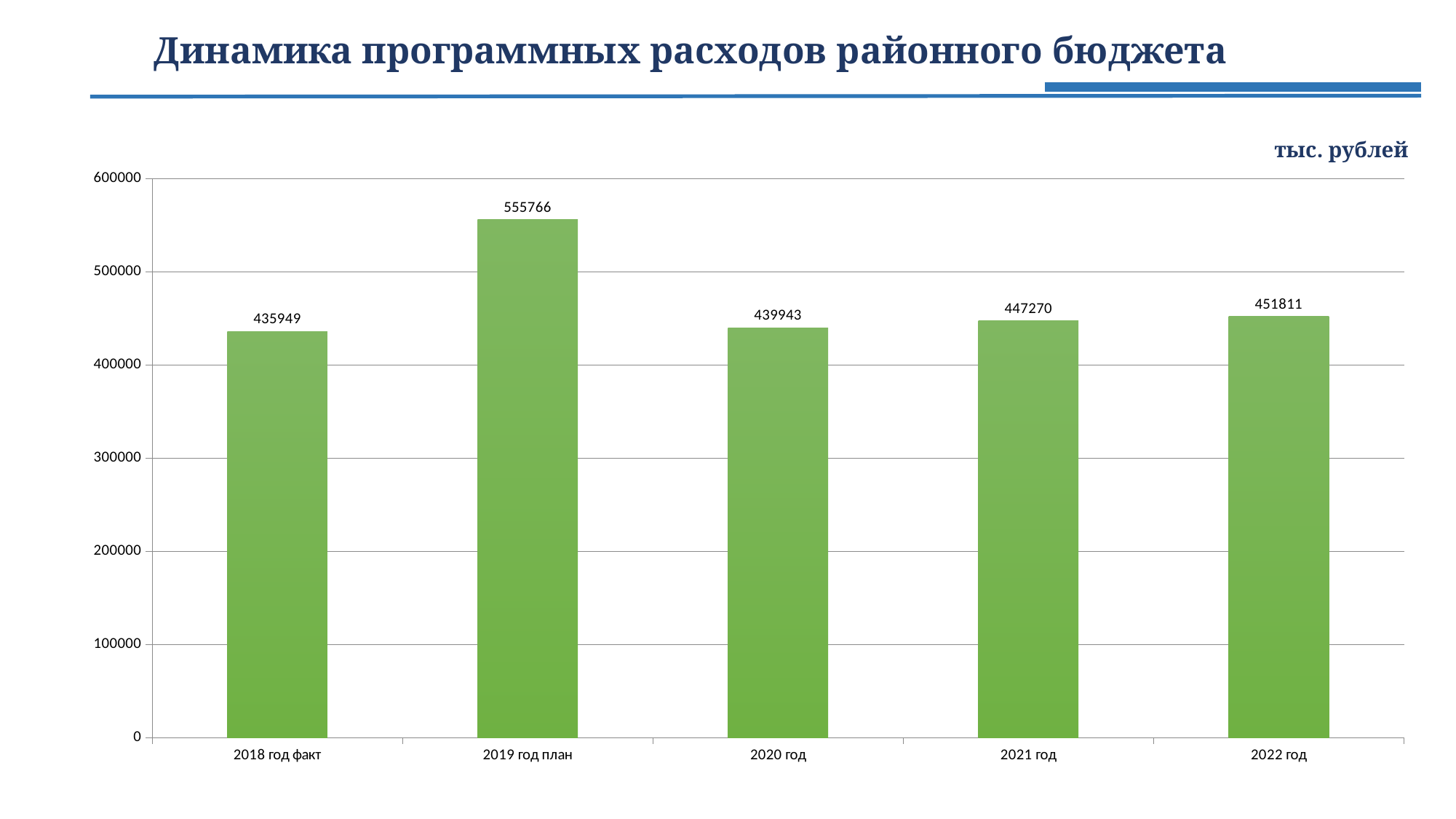
What kind of chart is shown on the slide? bar chart What is the difference between the values for 2019 год план and 2018 год факт? 119817 Which is larger, the value for 2020 год or the value for 2021 год? 2021 год Which category has the lowest value? 2018 год факт Is the value for 2019 год план greater or less than 500000? greater How many bars are shown in the chart? 5 What is the value for 2019 год план? 555766 Which category has the highest value? 2019 год план What is the value for 2022 год? 451811 What is the difference between the values for 2022 год and 2021 год? 4541 What is the value for 2018 год факт? 435949 What unit of measurement is indicated above the chart? тыс. рублей